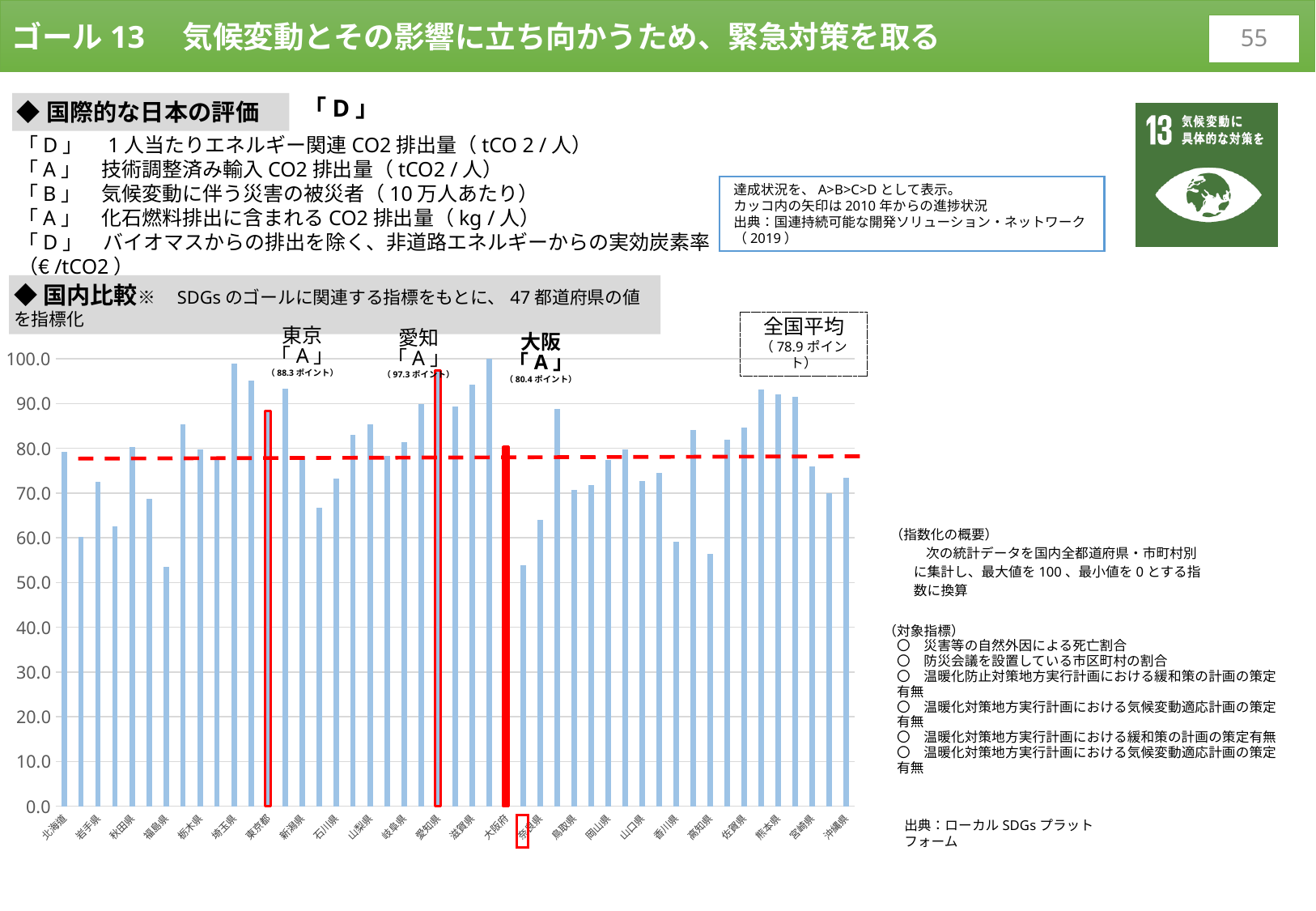
What is the difference between the printed values for 愛知 and 東京? 9.0 ポイント Which has the larger printed value, 愛知 or 大阪? 愛知 What kind of chart is used for the 国内比較? bar chart What is the difference between the printed values for 東京 and 大阪? 7.9 ポイント What is the value printed for 大阪 in the 国内比較 chart? 80.4 ポイント What is the 全国平均 value shown on the chart? 78.9 ポイント What is the value printed for 愛知 in the 国内比較 chart? 97.3 ポイント Is the value for 北海道 greater or less than 70.0? greater Is the printed value for 大阪 greater or less than the 全国平均? greater What does the red dashed horizontal line on the chart represent? 全国平均 (78.9 ポイント) Is the value for 福島県 greater or less than 60.0? less What is the value printed for 東京 in the 国内比較 chart? 88.3 ポイント